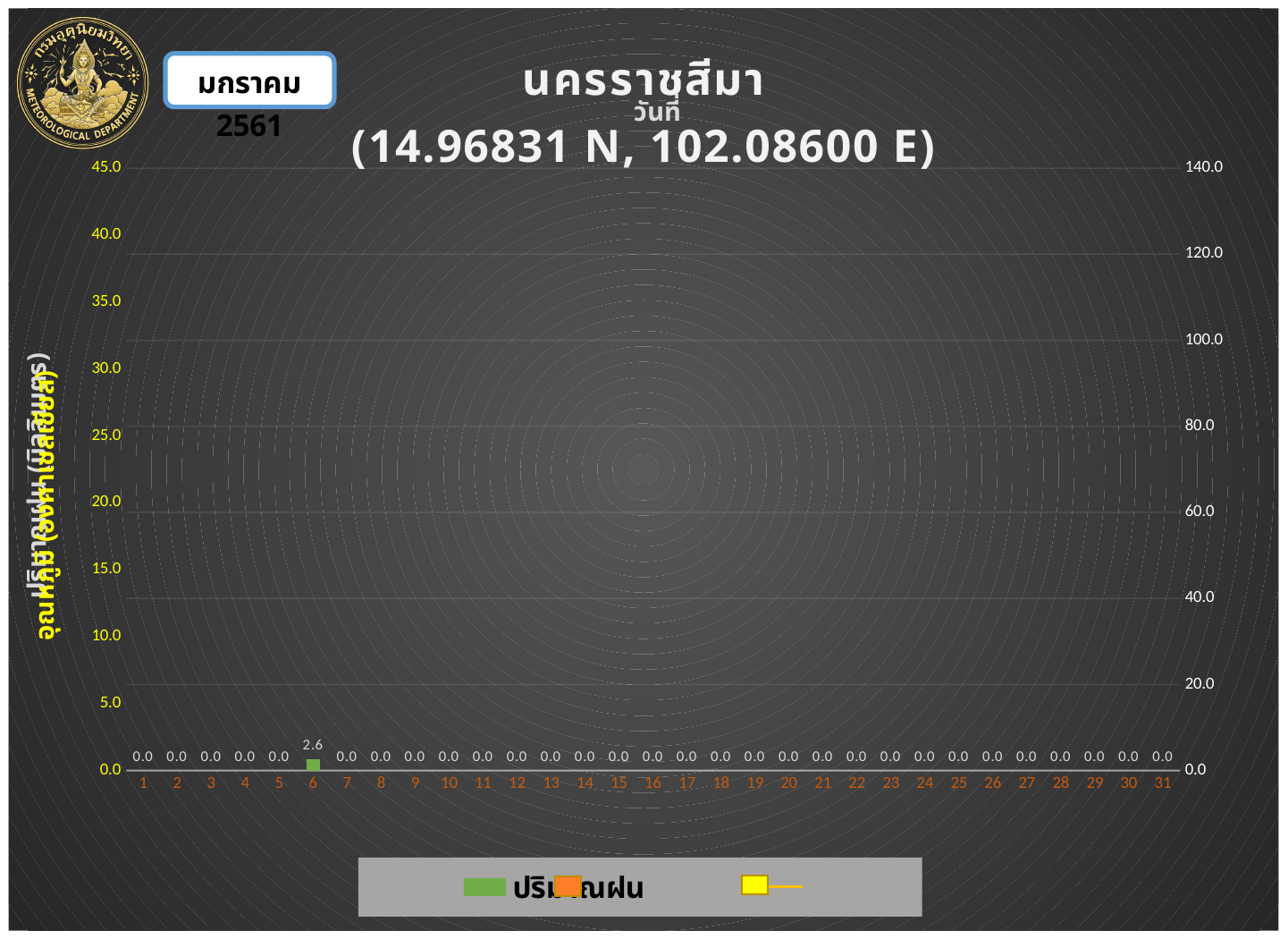
What is the rainfall value shown for day 6? 2.6 What is the rainfall value shown for day 31? 0.0 Is the rainfall value for day 6 greater or less than 5.0? less What kind of chart is used to show the rainfall values? bar chart How many days are shown on the x axis? 31 What is the rainfall value shown for day 15? 0.0 What is the highest tick value on the left vertical axis? 45.0 Which has the larger rainfall value, day 6 or day 20? day 6 What is the rainfall value shown for day 1? 0.0 What is the highest tick value on the right vertical axis? 140.0 Which day has the highest rainfall value? 6 What is the difference between the rainfall value for day 6 and the value for day 7? 2.6